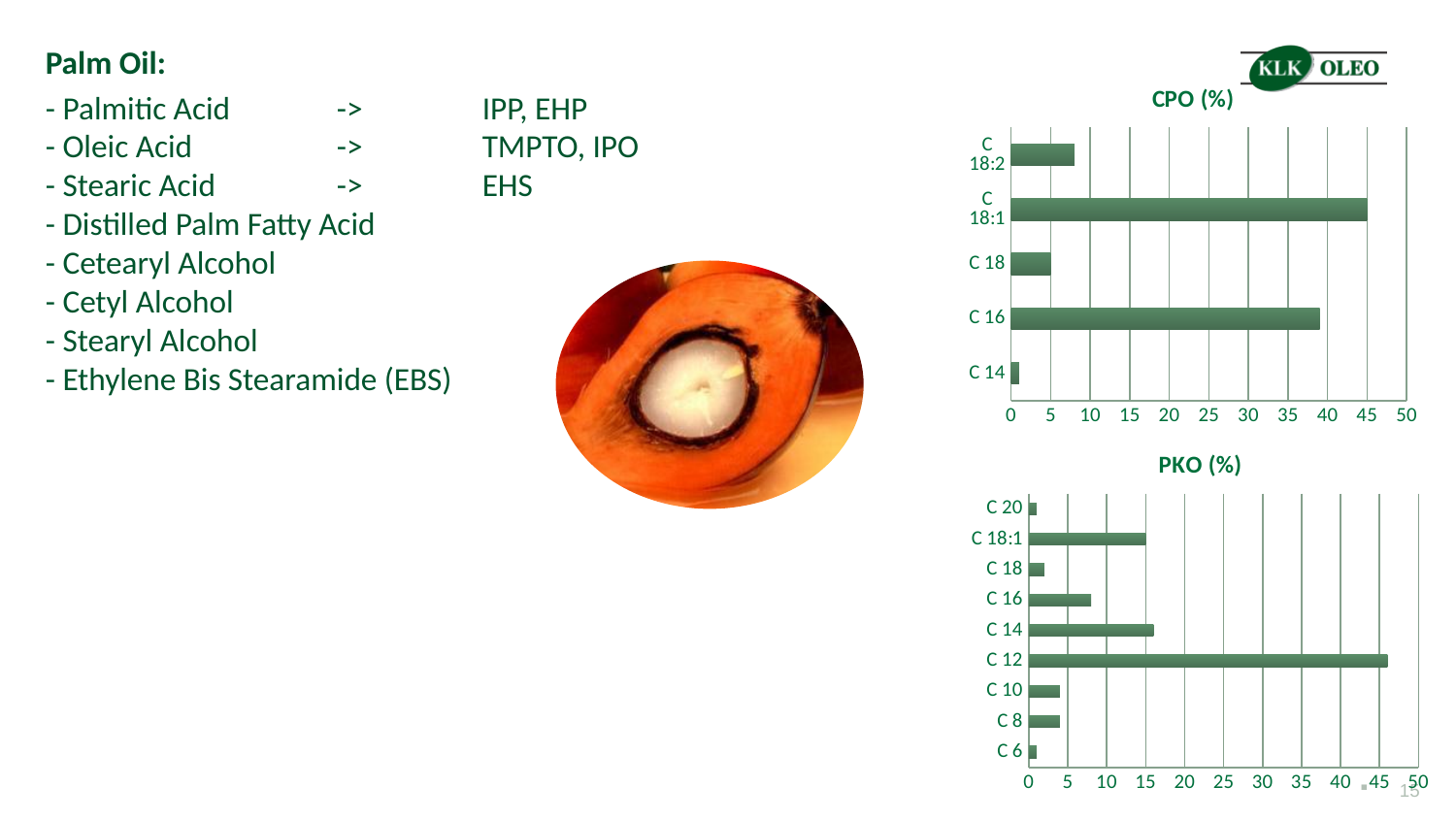
How many categories are shown in the CPO (%) chart? 5 In the PKO (%) chart, which is larger, the value for C 16 or the value for C 10? C 16 In the CPO (%) chart, which category has the lowest value? C 14 In the CPO (%) chart, is the value for C 18:2 greater or less than 10? less In the CPO (%) chart, is the value for C 18:1 greater or less than 40? greater How many categories are shown in the PKO (%) chart? 9 In the PKO (%) chart, which category has the highest value? C 12 In the PKO (%) chart, is the value for C 12 greater or less than 40? greater What kind of chart is the CPO (%) chart? bar chart In the CPO (%) chart, which is larger, the value for C 18:1 or the value for C 16? C 18:1 In the CPO (%) chart, which category has the highest value? C 18:1